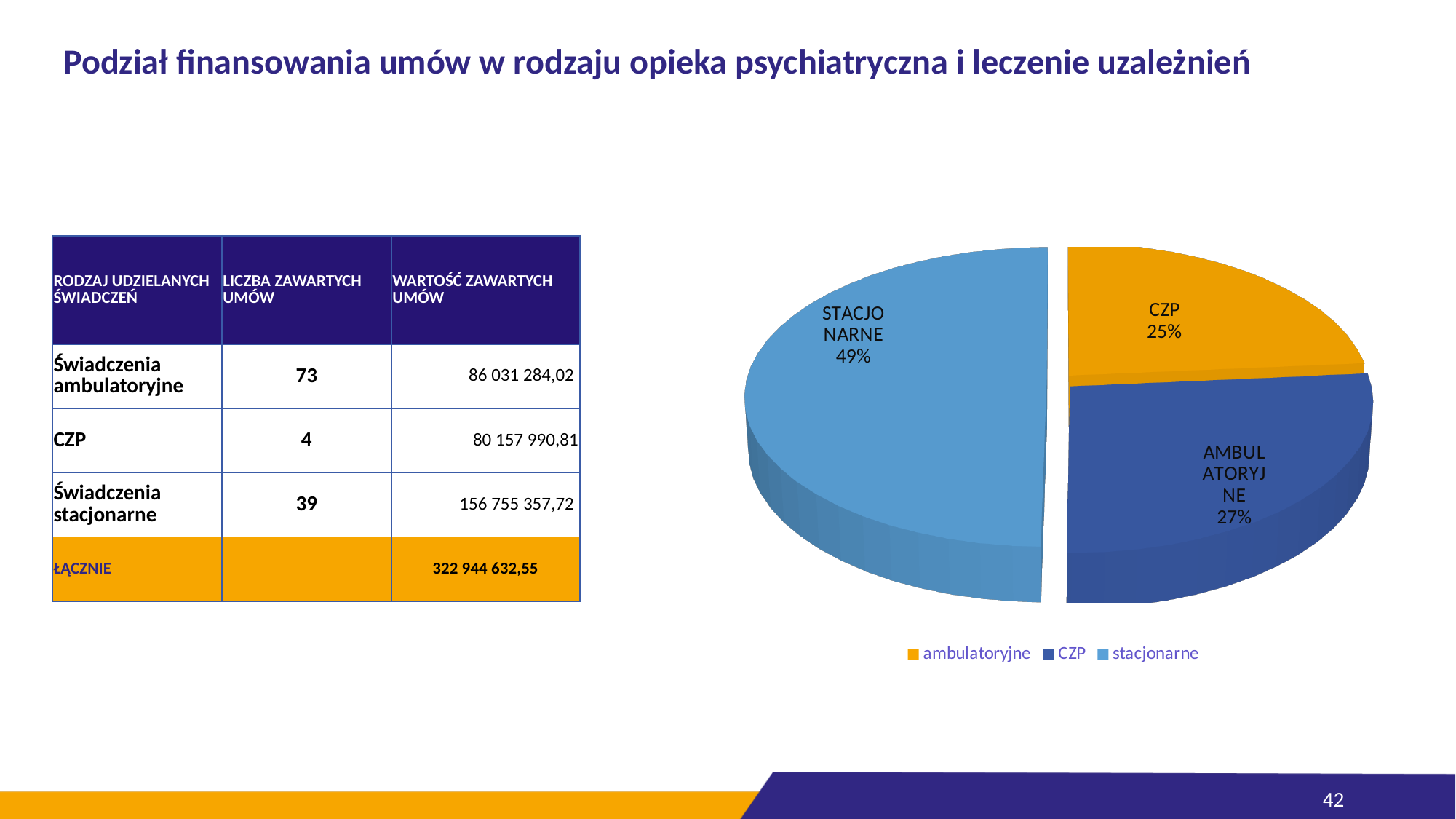
How many slices does the pie chart have? 3 By how many percentage points is the STACJONARNE slice larger than the CZP slice? 24% Which slice is larger, AMBULATORYJNE or CZP? AMBULATORYJNE What share of the pie does the AMBULATORYJNE slice represent? 27% Which slice of the pie chart is the smallest? CZP Which slice of the pie chart is the largest? STACJONARNE What kind of chart is shown on the slide? pie chart How many entries does the legend of the pie chart list? 3 What share of the pie does the STACJONARNE slice represent? 49% What are the entries listed in the legend of the pie chart? ambulatoryjne, CZP, stacjonarne What share of the pie does the CZP slice represent? 25% By how many percentage points is the STACJONARNE slice larger than the AMBULATORYJNE slice? 22%